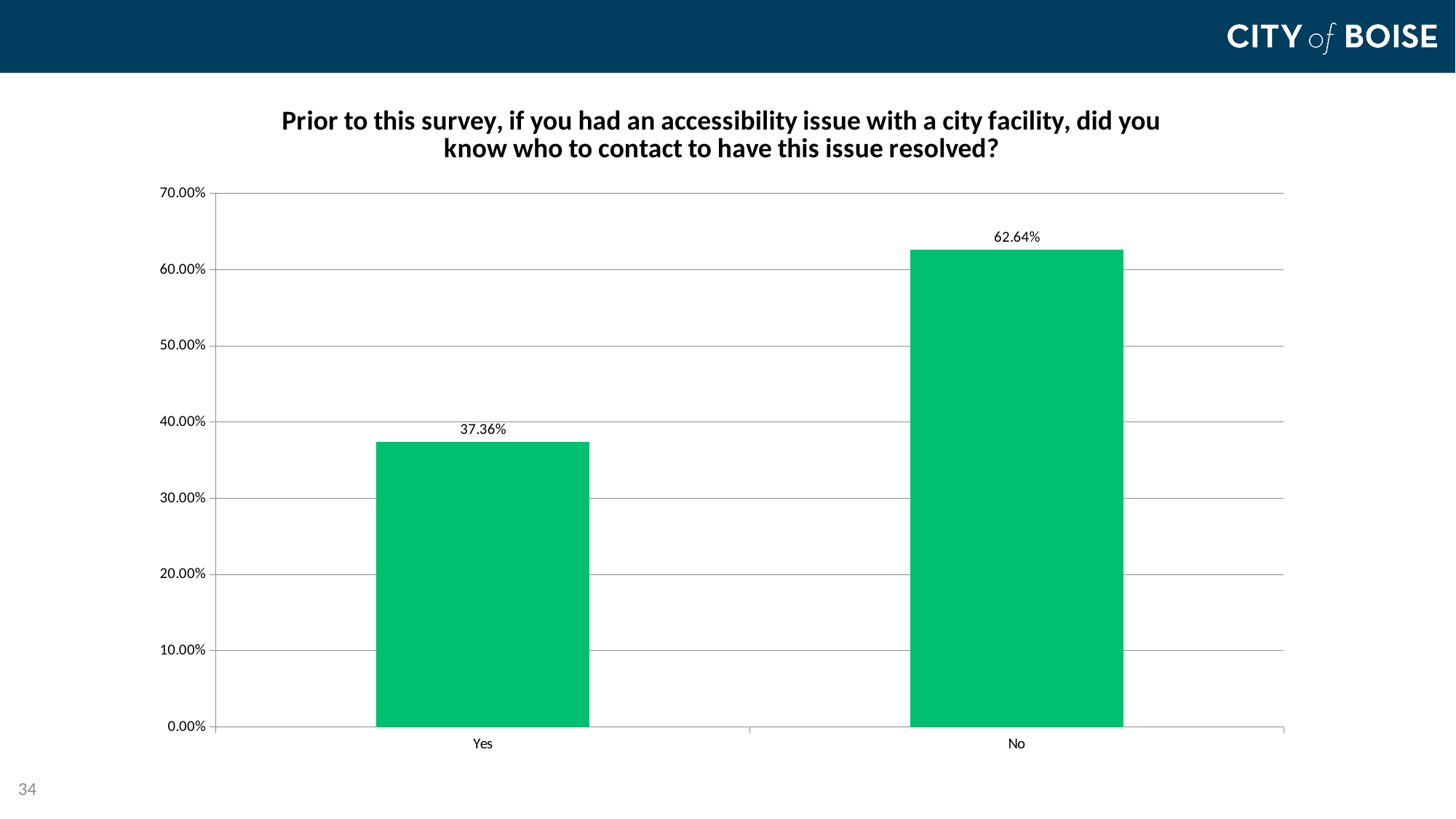
Is the value for "No" greater or less than 60.00%? greater What kind of chart is shown on the slide? bar chart Which is larger, the value for "Yes" or the value for "No"? No What is the difference between the "No" and "Yes" percentages? 25.28% What is the highest value shown on the y axis? 70.00% Which response category has the highest value? No Is the value for "Yes" greater or less than 40.00%? less How many response categories are shown on the x axis? 2 What is the total of the "Yes" and "No" percentages? 100.00% What percentage of respondents answered "Yes"? 37.36% What percentage of respondents answered "No"? 62.64% Which response category has the lowest value? Yes